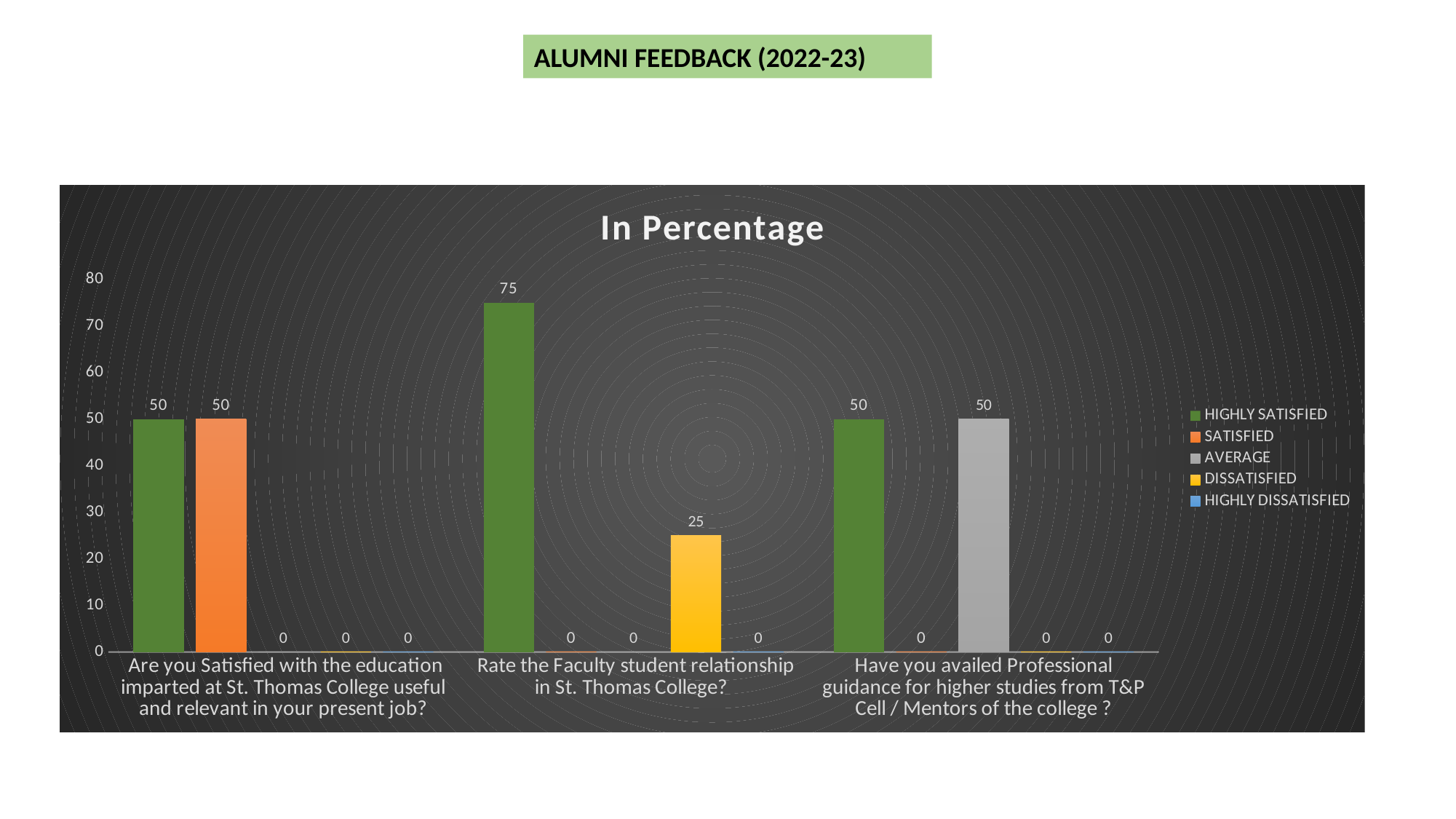
Is the HIGHLY SATISFIED value for "Rate the Faculty student relationship in St. Thomas College?" greater or less than 70? greater What is the SATISFIED value for "Are you Satisfied with the education imparted at St. Thomas College useful and relevant in your present job?"? 50 Which question category has the highest HIGHLY SATISFIED value? Rate the Faculty student relationship in St. Thomas College? What is the AVERAGE value for "Have you availed Professional guidance for higher studies from T&P Cell / Mentors of the college ?"? 50 What type of chart is shown on the slide? bar chart What is the DISSATISFIED value for "Rate the Faculty student relationship in St. Thomas College?"? 25 Which colour represents the AVERAGE series in the legend? grey What is the HIGHLY SATISFIED value for "Rate the Faculty student relationship in St. Thomas College?"? 75 How many series does the legend list? 5 How many question categories are shown on the x axis? 3 What is the difference between the HIGHLY SATISFIED and DISSATISFIED values for "Rate the Faculty student relationship in St. Thomas College?"? 50 What is the title of the chart? In Percentage